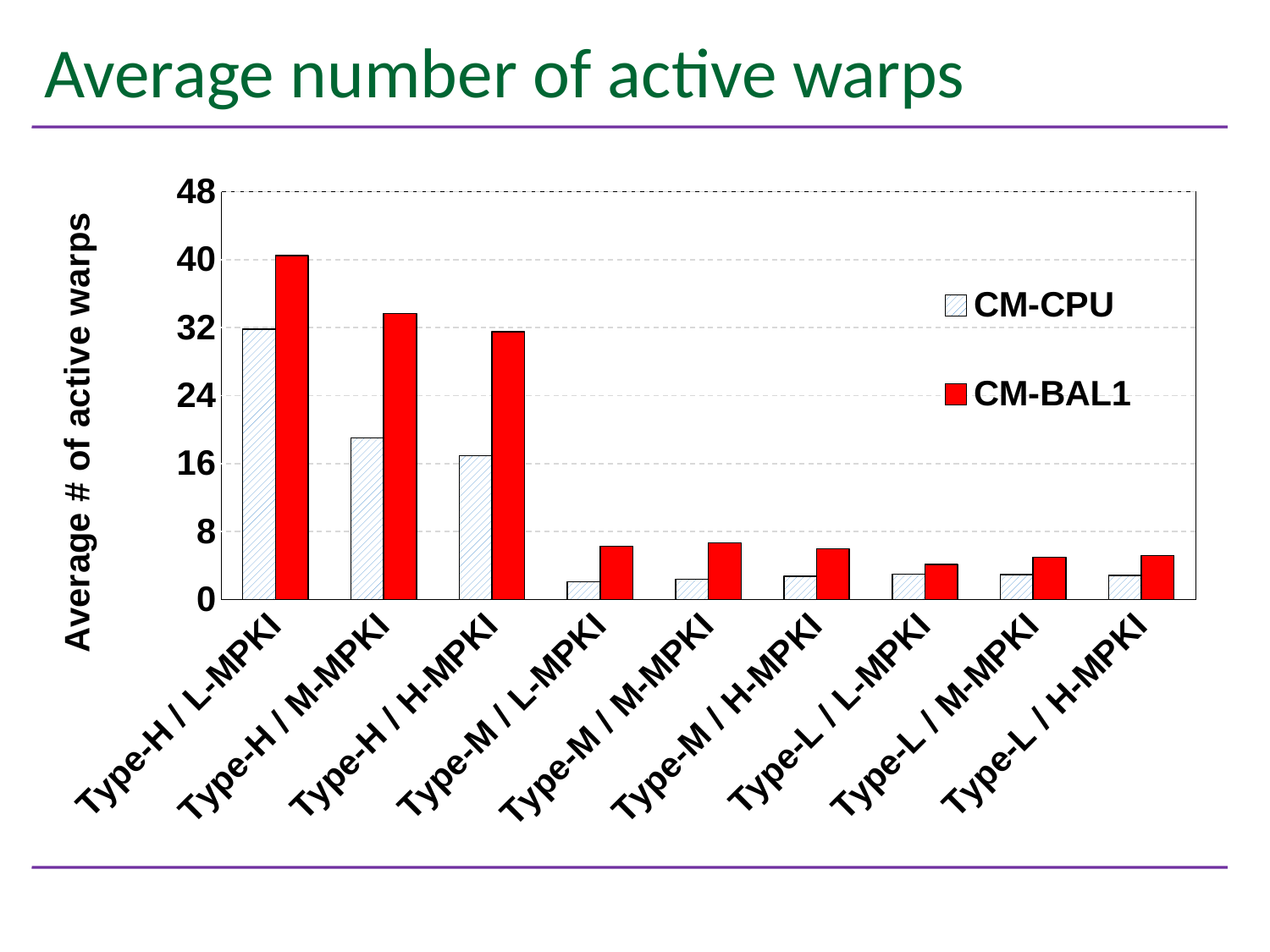
Is the CM-BAL1 value for Type-H / L-MPKI greater or less than 32? greater What kind of chart is shown on the slide? bar chart Which category has the highest CM-BAL1 value? Type-H / L-MPKI Which category has the highest CM-CPU value? Type-H / L-MPKI How many categories are shown along the x axis? 9 What is the label of the y axis? Average # of active warps How many series does the legend list? 2 Which is larger: the CM-BAL1 value for Type-H / H-MPKI or the CM-BAL1 value for Type-M / L-MPKI? Type-H / H-MPKI Is the CM-CPU value for Type-H / H-MPKI greater or less than 24? less Is the CM-CPU value for Type-H / M-MPKI greater or less than 16? greater For Type-H / L-MPKI, which series has the larger value, CM-CPU or CM-BAL1? CM-BAL1